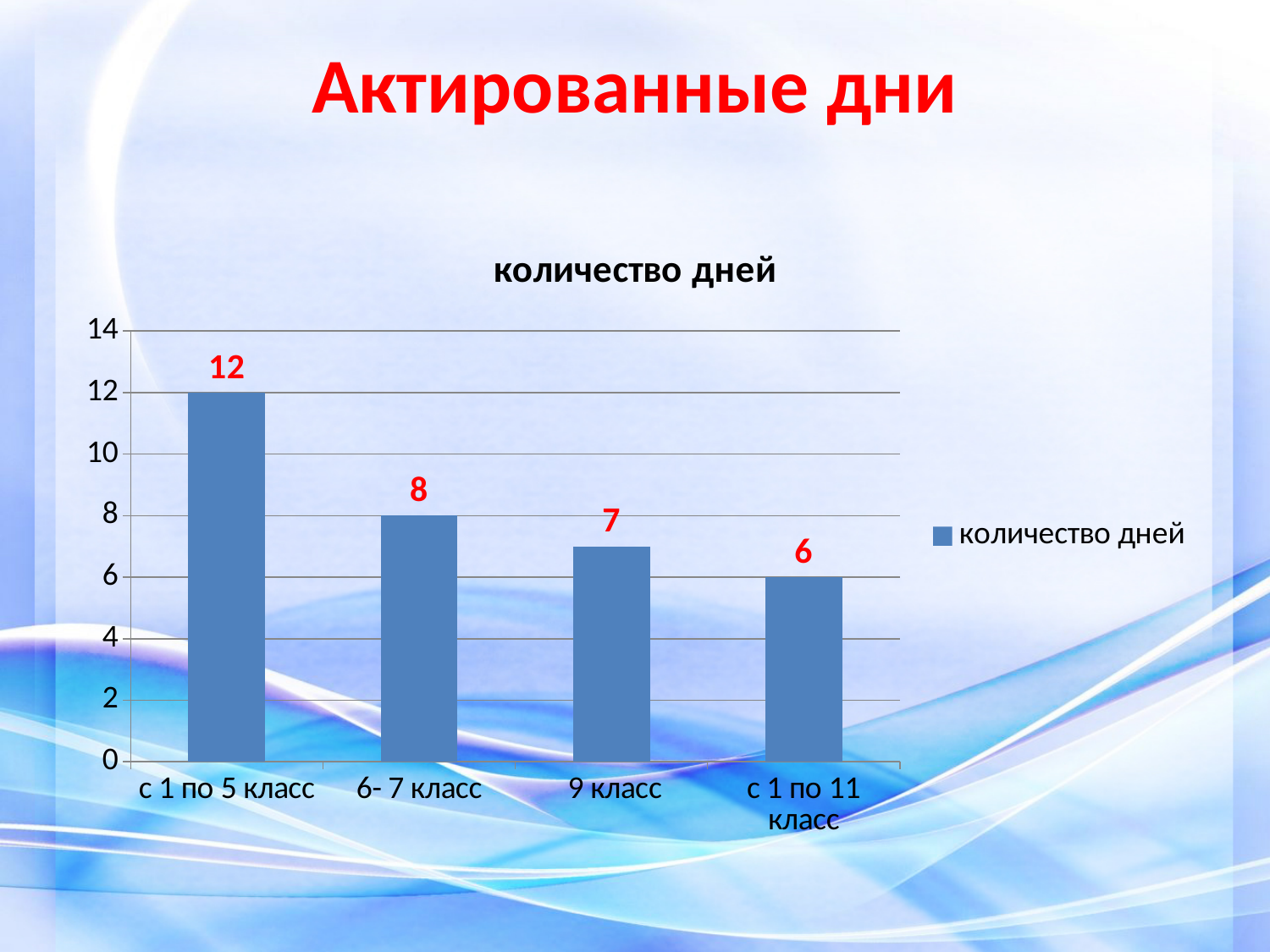
What is the value for "9 класс"? 7 Which category has the lowest value? с 1 по 11 класс How many series does the legend list? 1 What is the value for "с 1 по 5 класс"? 12 What is the value for "с 1 по 11 класс"? 6 Do the values rise or fall from left to right along the x axis? fall How many categories are shown on the x axis? 4 Which is larger, the value for "9 класс" or the value for "с 1 по 11 класс"? 9 класс What kind of chart is shown on the slide? bar chart Which category has the highest value? с 1 по 5 класс What is the difference between the values for "с 1 по 5 класс" and "6- 7 класс"? 4 What is the value for "6- 7 класс"? 8